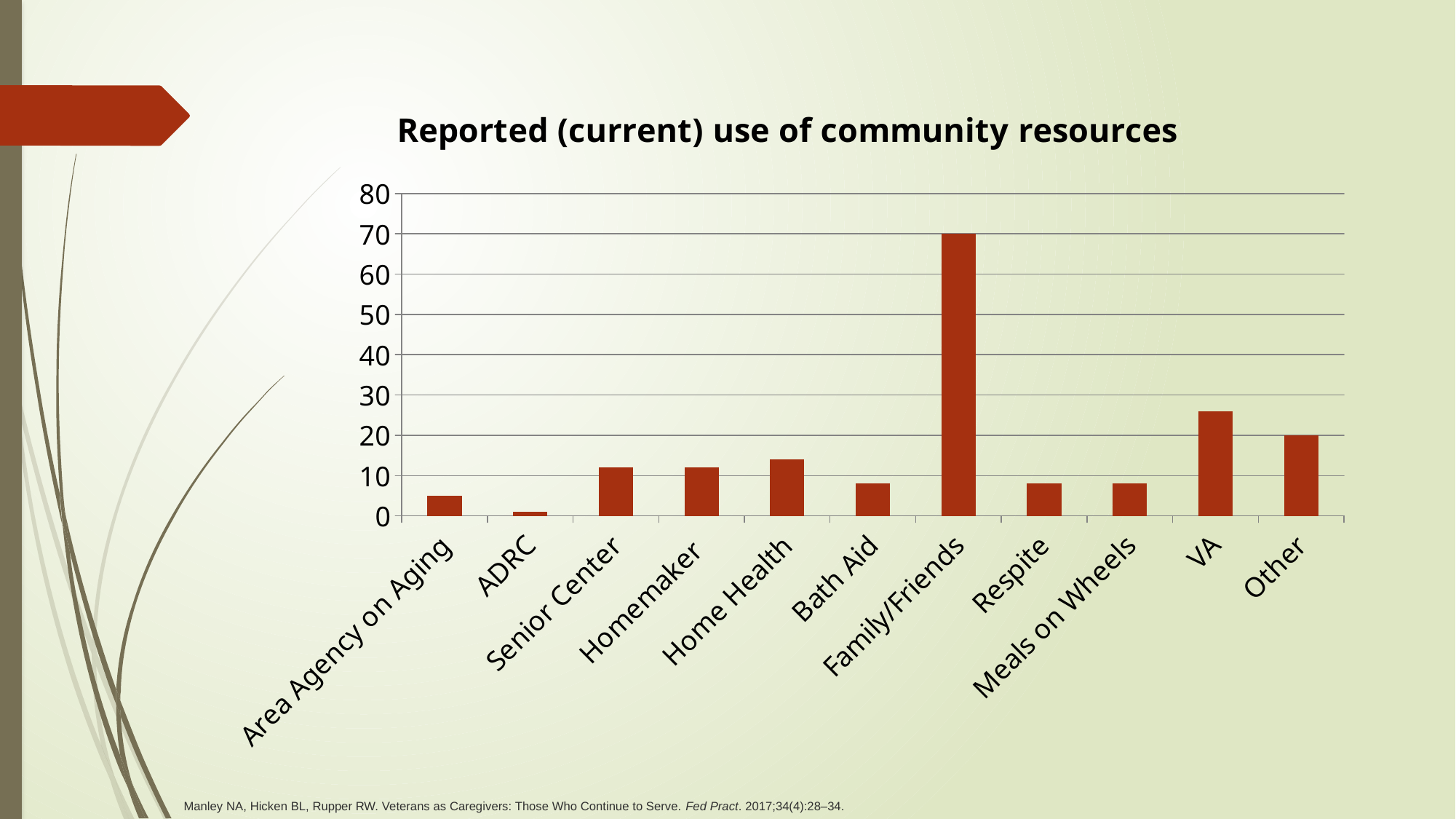
Which is larger, the value for VA or the value for Other? VA What type of chart is shown on the slide? Bar chart What is the value for Family/Friends? 70 What is the title of the chart? Reported (current) use of community resources How many categories are shown on the x axis of the chart? 11 Which is larger, the value for Home Health or the value for Bath Aid? Home Health What is the value for Other? 20 What is the difference between the values for Family/Friends and Other? 50 Which category has the lowest value? ADRC Is the value for Area Agency on Aging greater or less than 10? less Is the value for VA greater or less than 20? greater Which category has the highest value? Family/Friends